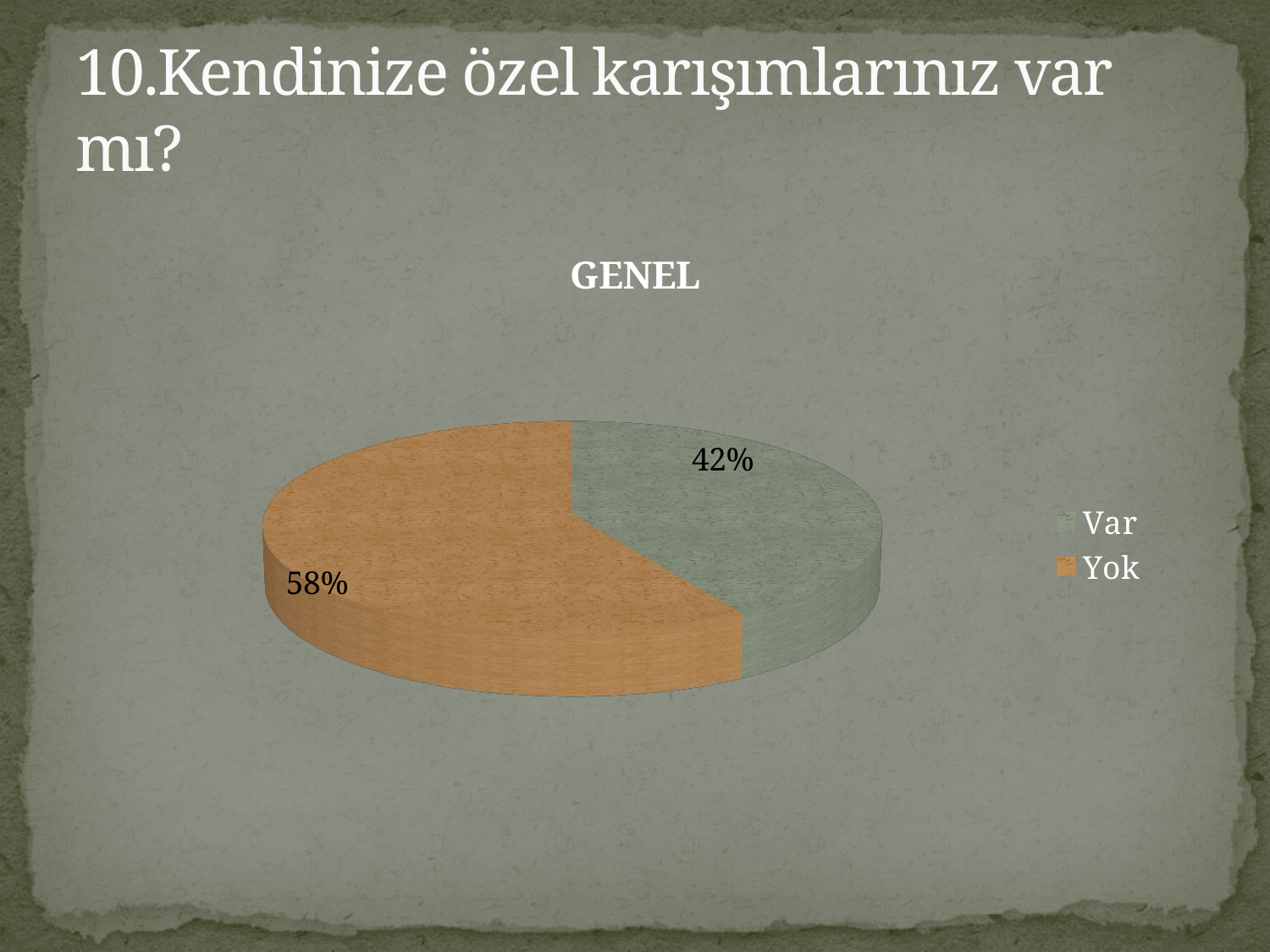
What is the title of the chart? GENEL How many entries does the legend list? 2 Which slice of the pie is the smallest? Var What kind of chart is shown on the slide? pie chart What percentage of the pie is labelled "Yok"? 58% What share of the pie does the "Yok" slice represent? 58% What is the difference in percentage points between the "Yok" slice and the "Var" slice? 16 How many slices does the pie chart have? 2 Which slice of the pie is the largest? Yok Which legend entry is shown in orange? Yok Which is larger, the "Var" slice or the "Yok" slice? Yok What percentage of the pie is labelled "Var"? 42%